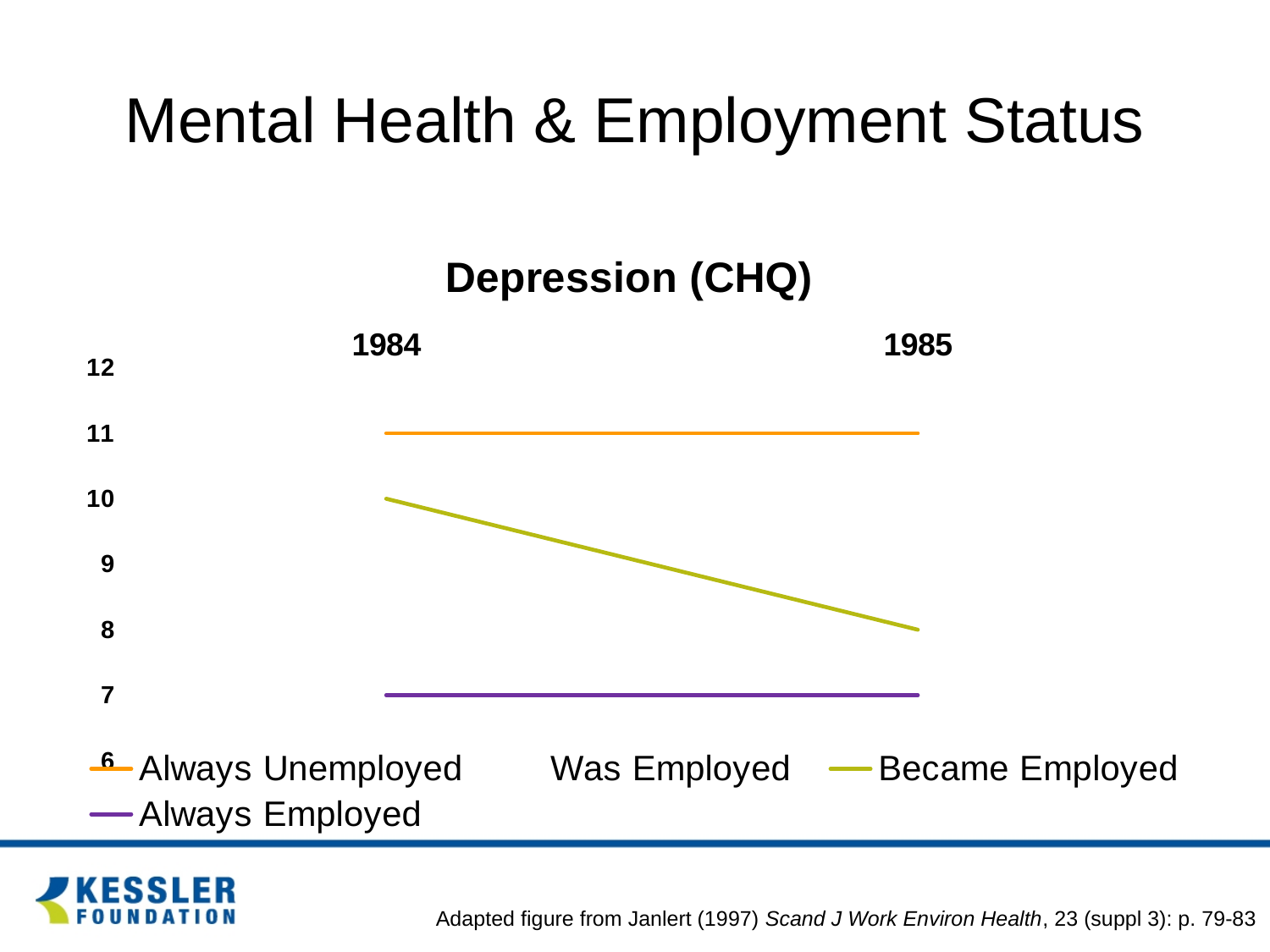
What is the value for Always Unemployed in 1984? 11 How many series does the legend list? 4 Which series has the highest value in 1985? Always Unemployed Which series has the lowest value in 1984? Always Employed What is the difference between the Became Employed values in 1984 and 1985? 2 What is the title of the chart? Depression (CHQ) Does the Became Employed line rise or fall from 1984 to 1985? fall What is the value for Became Employed in 1985? 8 What kind of chart is shown on the slide? line chart How many years are shown on the x axis? 2 What is the value for Always Employed in 1985? 7 What is the value for Became Employed in 1984? 10